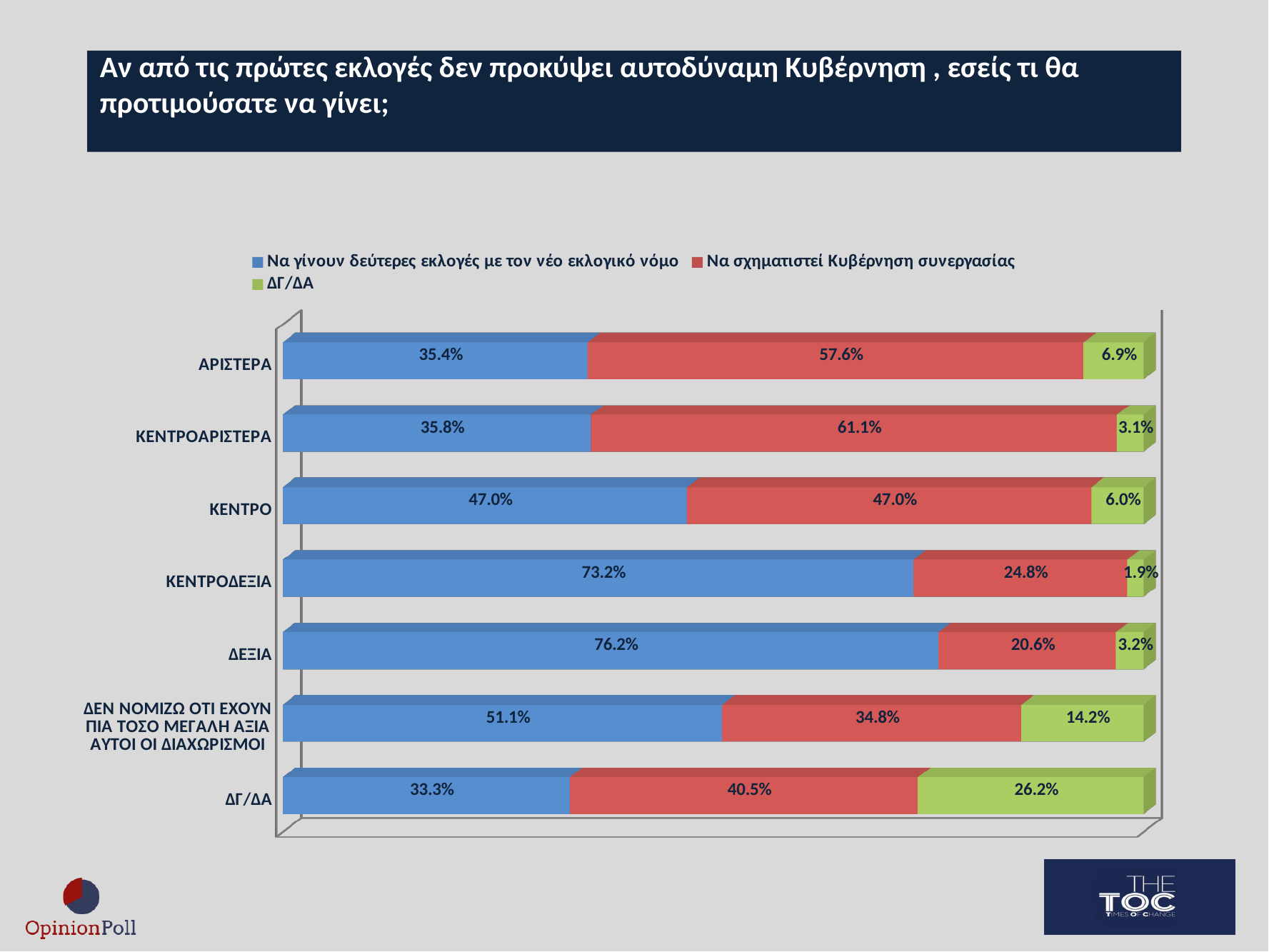
What colour represents the series 'Να σχηματιστεί Κυβέρνηση συνεργασίας'? Red What is the value of 'Να γίνουν δεύτερες εκλογές με τον νέο εκλογικό νόμο' for ΔΕΞΙΑ? 76.2% What type of chart is shown on the slide? Stacked bar chart What is the ΔΓ/ΔΑ value for the category ΔΓ/ΔΑ? 26.2% Which category has the highest value for 'Να γίνουν δεύτερες εκλογές με τον νέο εκλογικό νόμο'? ΔΕΞΙΑ How many categories are shown on the vertical axis? 7 Which category has the lowest ΔΓ/ΔΑ value? ΚΕΝΤΡΟΔΕΞΙΑ Which category has the lowest value for 'Να σχηματιστεί Κυβέρνηση συνεργασίας'? ΔΕΞΙΑ How many series does the legend list? 3 What is the value of 'Να σχηματιστεί Κυβέρνηση συνεργασίας' for ΚΕΝΤΡΟΑΡΙΣΤΕΡΑ? 61.1% Which is larger: the 'Να σχηματιστεί Κυβέρνηση συνεργασίας' value for ΑΡΙΣΤΕΡΑ or for ΚΕΝΤΡΟΔΕΞΙΑ? ΑΡΙΣΤΕΡΑ What is the difference between the 'Να γίνουν δεύτερες εκλογές με τον νέο εκλογικό νόμο' values for ΔΕΞΙΑ and ΑΡΙΣΤΕΡΑ? 40.8%